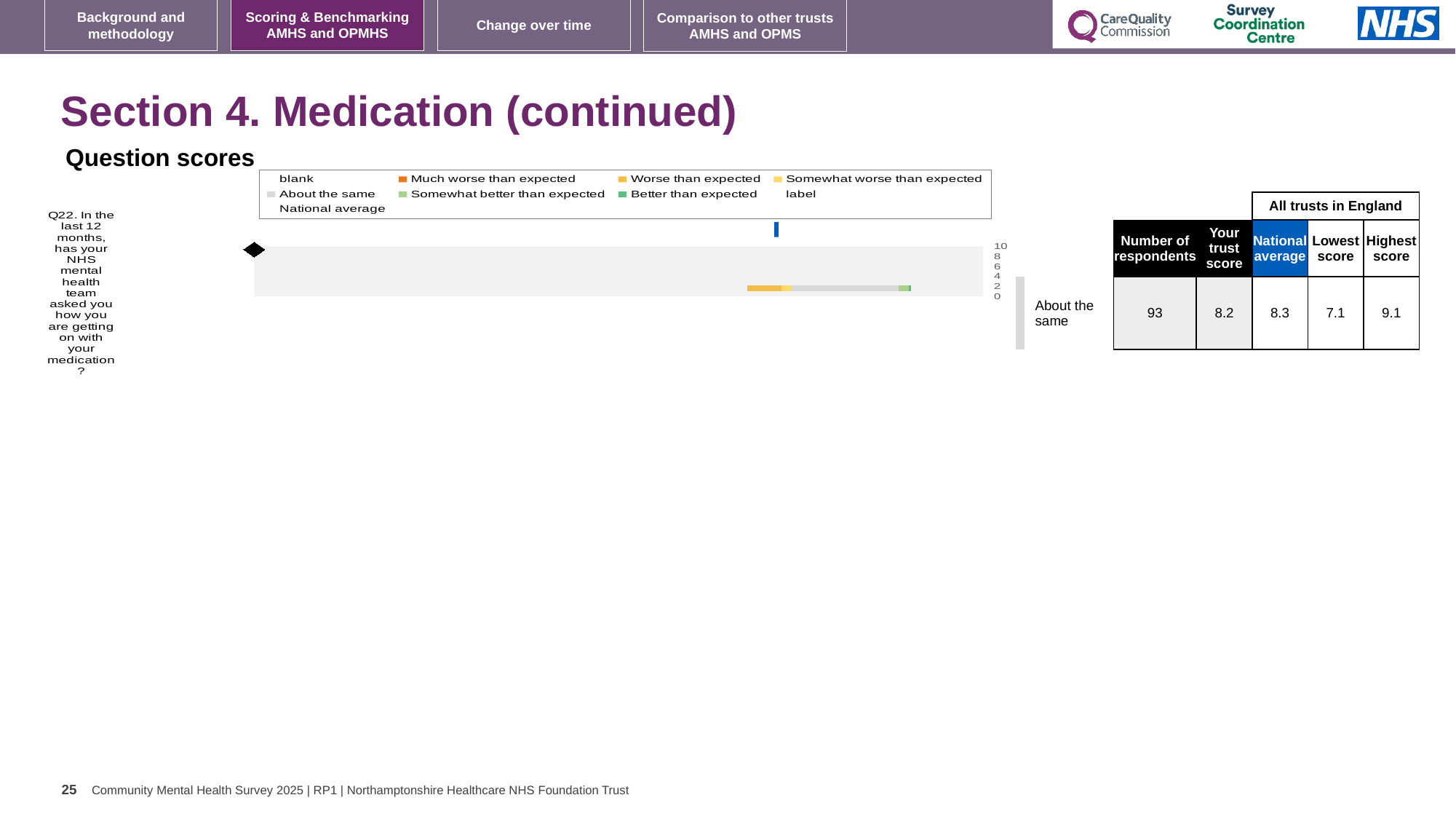
According to the table beside the chart, what is the national average for Q22? 8.3 What is the highest tick value shown on the chart's axis? 10 What kind of chart is shown under 'Question scores'? bar chart How many respondents answered Q22, according to the table beside the chart? 93 What comparison category is the trust's Q22 score assigned to, as labelled next to the chart? About the same What is the difference between the highest score and the lowest score for Q22 in the table beside the chart? 2.0 According to the table beside the chart, what is the trust's score for Q22? 8.2 Which is larger for Q22: the trust's score or the national average? national average According to the table beside the chart, what is the highest score among all trusts in England for Q22? 9.1 According to the table beside the chart, what is the lowest score among all trusts in England for Q22? 7.1 Which question number is plotted on the chart? Q22 How many entries does the chart legend list? 9